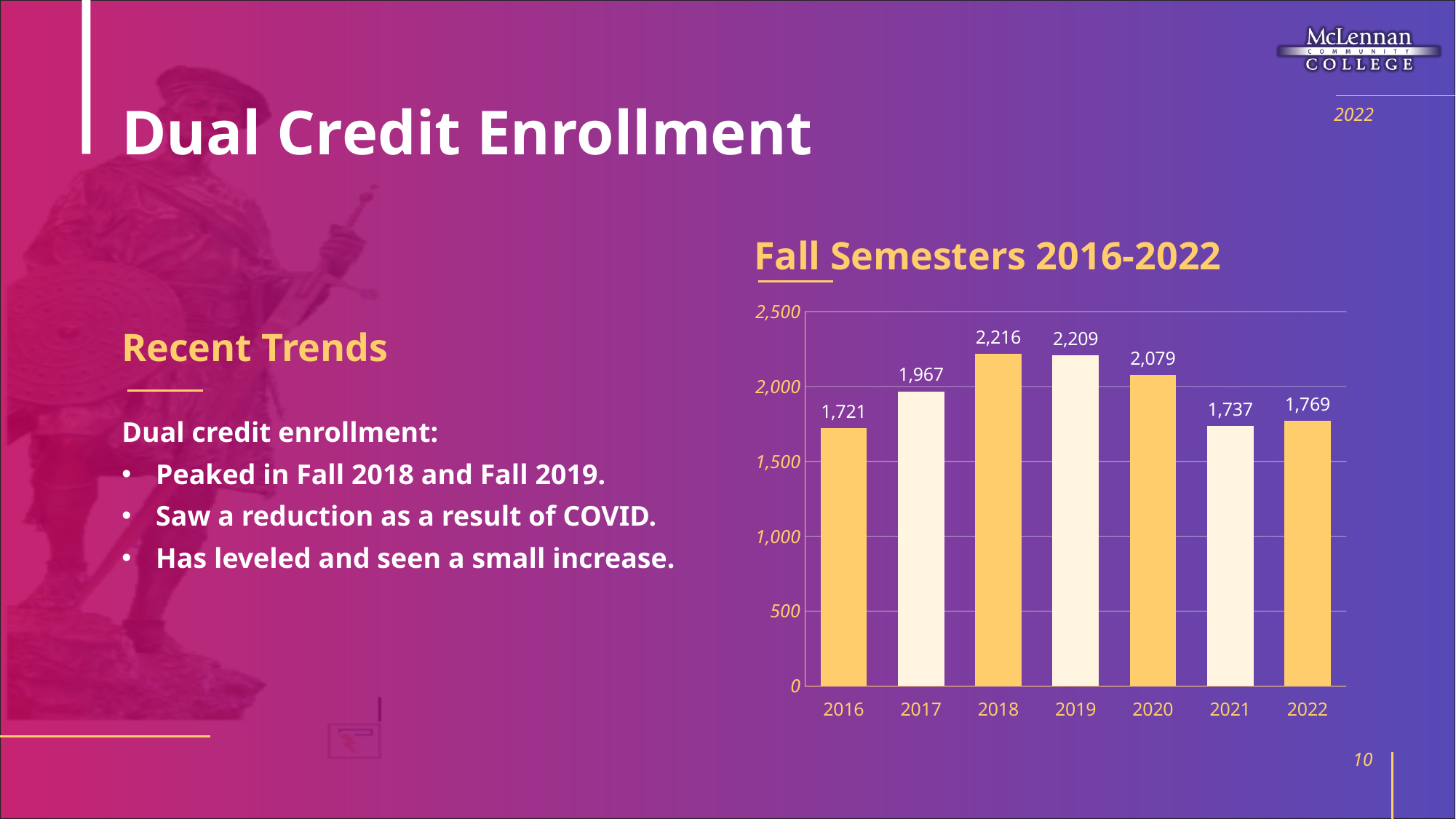
What is the difference in enrollment between 2022 and 2021? 32 What is the difference in enrollment between 2018 and 2021? 479 How many years are shown on the chart? 7 What kind of chart is shown on the slide? Bar chart What was the dual credit enrollment in Fall 2016? 1,721 What was the dual credit enrollment in Fall 2022? 1,769 What is the title of the chart? Fall Semesters 2016-2022 Is the enrollment value for 2019 greater or less than 2,000? greater Which year had higher enrollment, 2017 or 2020? 2020 Which year had the lowest dual credit enrollment? 2016 Which year had the highest dual credit enrollment? 2018 What was the dual credit enrollment in Fall 2018? 2,216